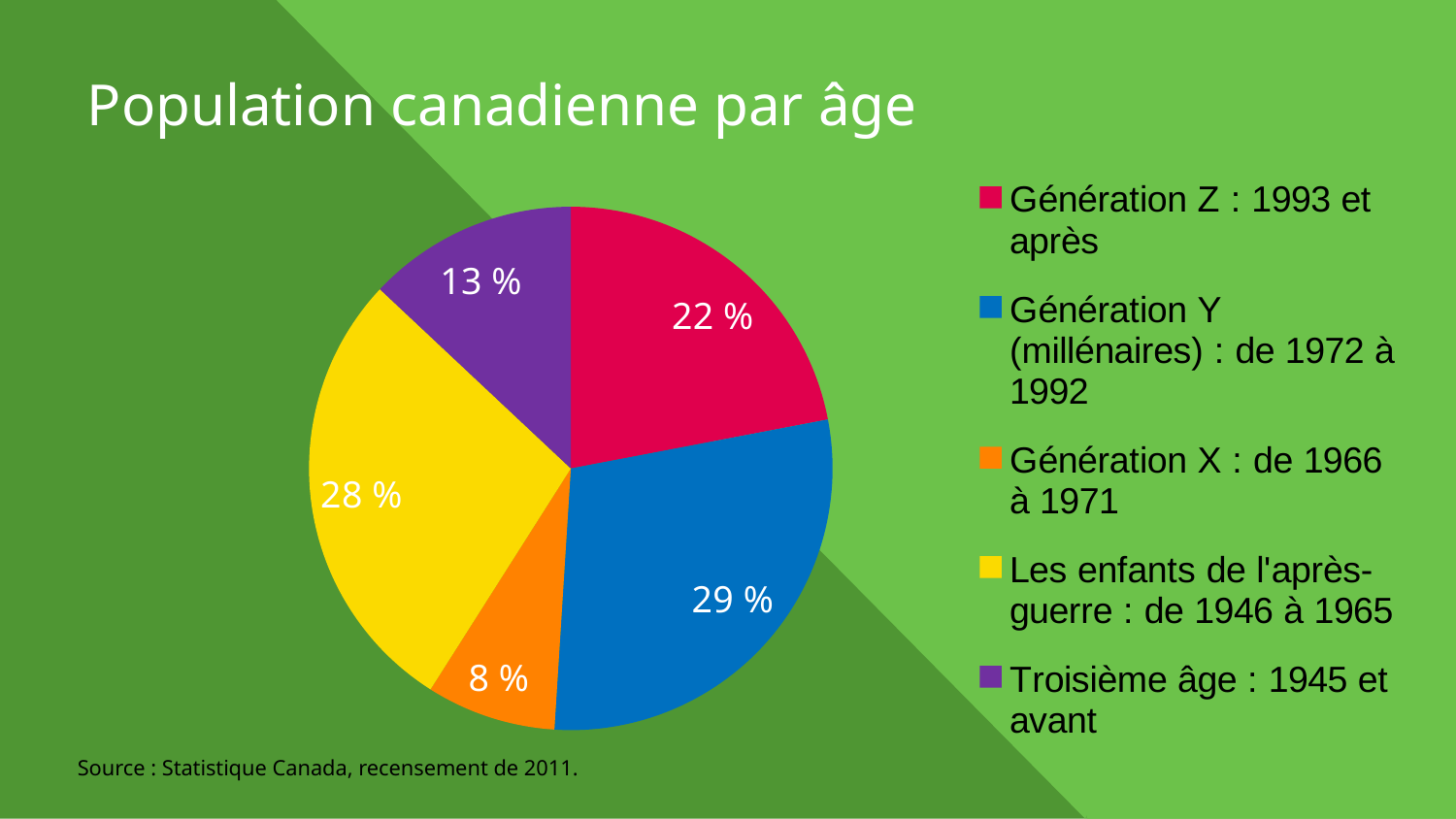
Which generation has the largest share of the pie? Génération Y (millénaires) : de 1972 à 1992 What share of the pie is labelled for Génération Z : 1993 et après? 22 % What share of the Canadian population is Génération Y (millénaires)? 29 % Which is larger, the share for Génération Z or the share for Troisième âge? Génération Z What percentage is shown for Troisième âge : 1945 et avant? 13 % What kind of chart is shown on the slide? Pie chart What percentage is shown for Les enfants de l'après-guerre : de 1946 à 1965? 28 % What is the title of the chart? Population canadienne par âge What colour is the slice for Génération X : de 1966 à 1971? Orange Which generation has the smallest share of the pie? Génération X : de 1966 à 1971 What is the difference in percentage points between Génération Z and Génération X? 14 How many slices does the pie chart have? 5